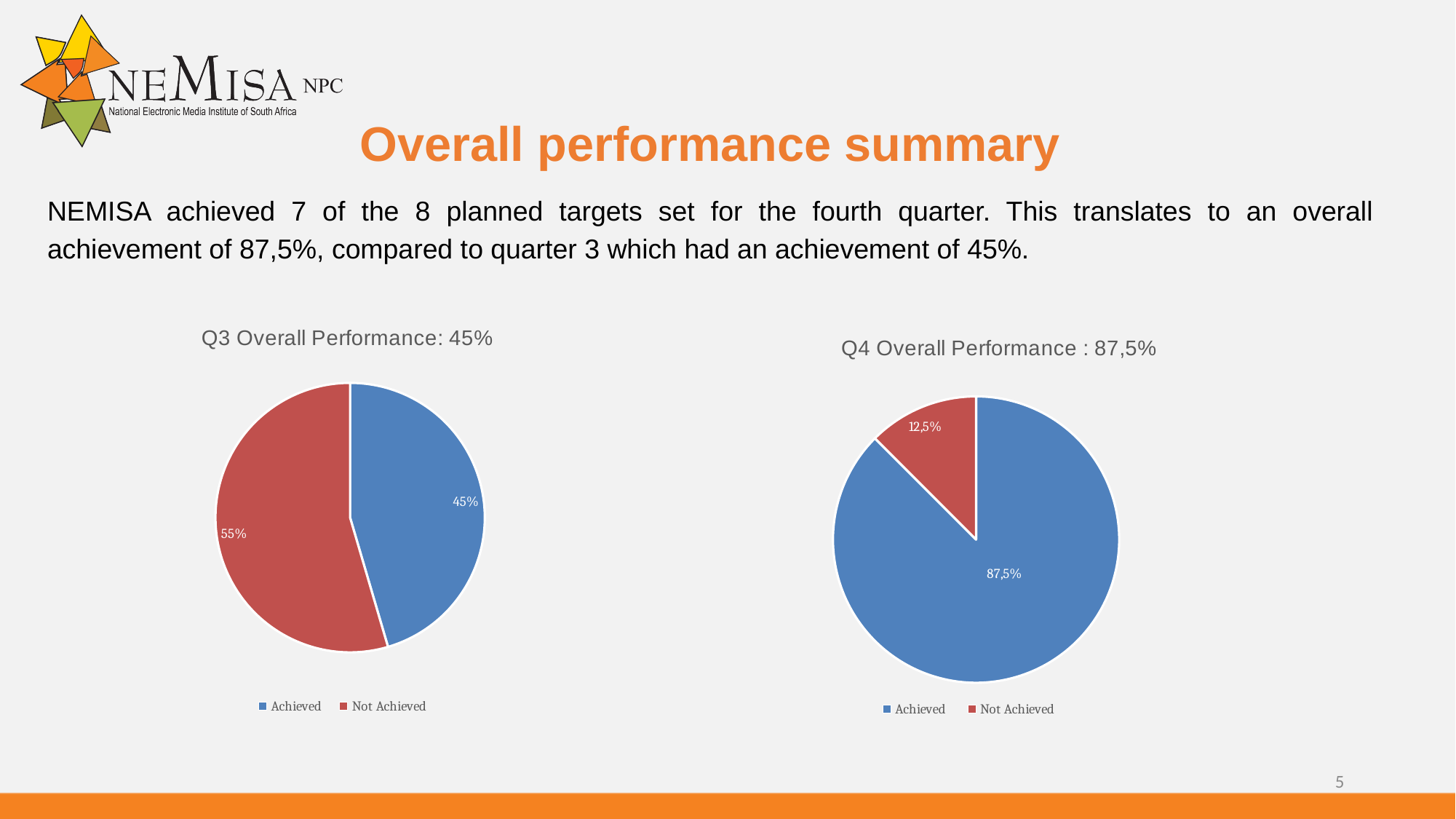
In the Q3 Overall Performance chart, what is the difference between the Not Achieved and Achieved shares? 10% In the Q3 Overall Performance chart, what share of the pie is Achieved? 45% What type of chart is the Q3 Overall Performance chart? Pie chart In the Q4 Overall Performance chart, what is the difference between the Achieved and Not Achieved shares? 75% How many slices does the Q4 Overall Performance chart have? 2 In the Q3 Overall Performance chart, what colour is the Not Achieved slice? Red In the Q4 Overall Performance chart, which slice is the smallest? Not Achieved In the Q4 Overall Performance chart, what share of the pie is Not Achieved? 12,5% In the Q4 Overall Performance chart, which slice is the largest? Achieved In the Q3 Overall Performance chart, which slice is larger, Achieved or Not Achieved? Not Achieved In the Q4 Overall Performance chart, what share of the pie is Achieved? 87,5%